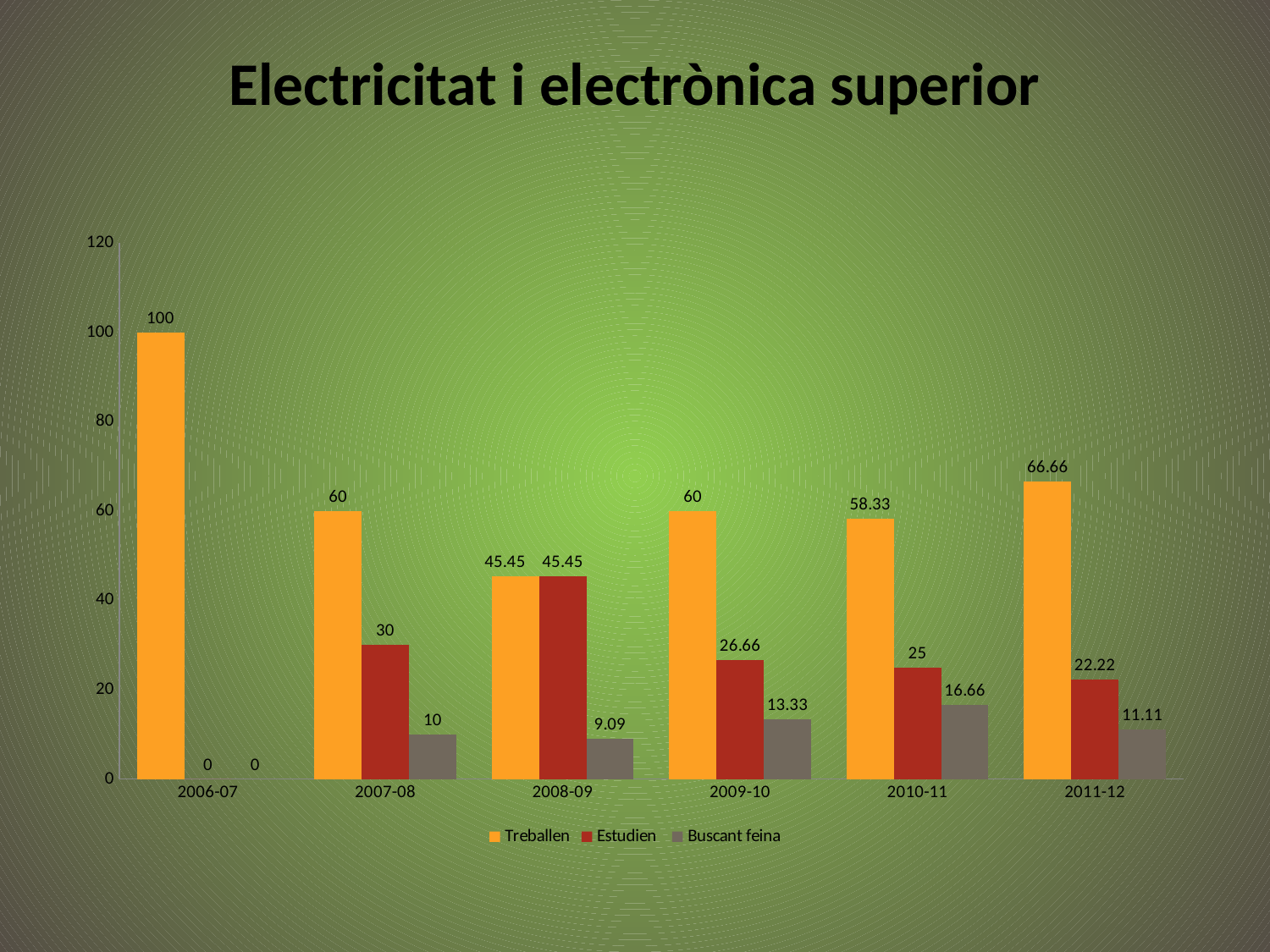
What is the value for Treballen in 2006-07? 100 What is the difference between Treballen and Estudien in 2007-08? 30 What is the value for Buscant feina in 2010-11? 16.66 What is the value for Estudien in 2008-09? 45.45 Which is larger in 2009-10, Estudien or Buscant feina? Estudien What is the title of the chart? Electricitat i electrònica superior How many series does the legend list? 3 In which year is the Buscant feina value lowest? 2006-07 How many years are shown on the x axis? 6 What kind of chart is shown on the slide? Bar chart In which year is the Treballen value highest? 2006-07 What is the value for Treballen in 2011-12? 66.66